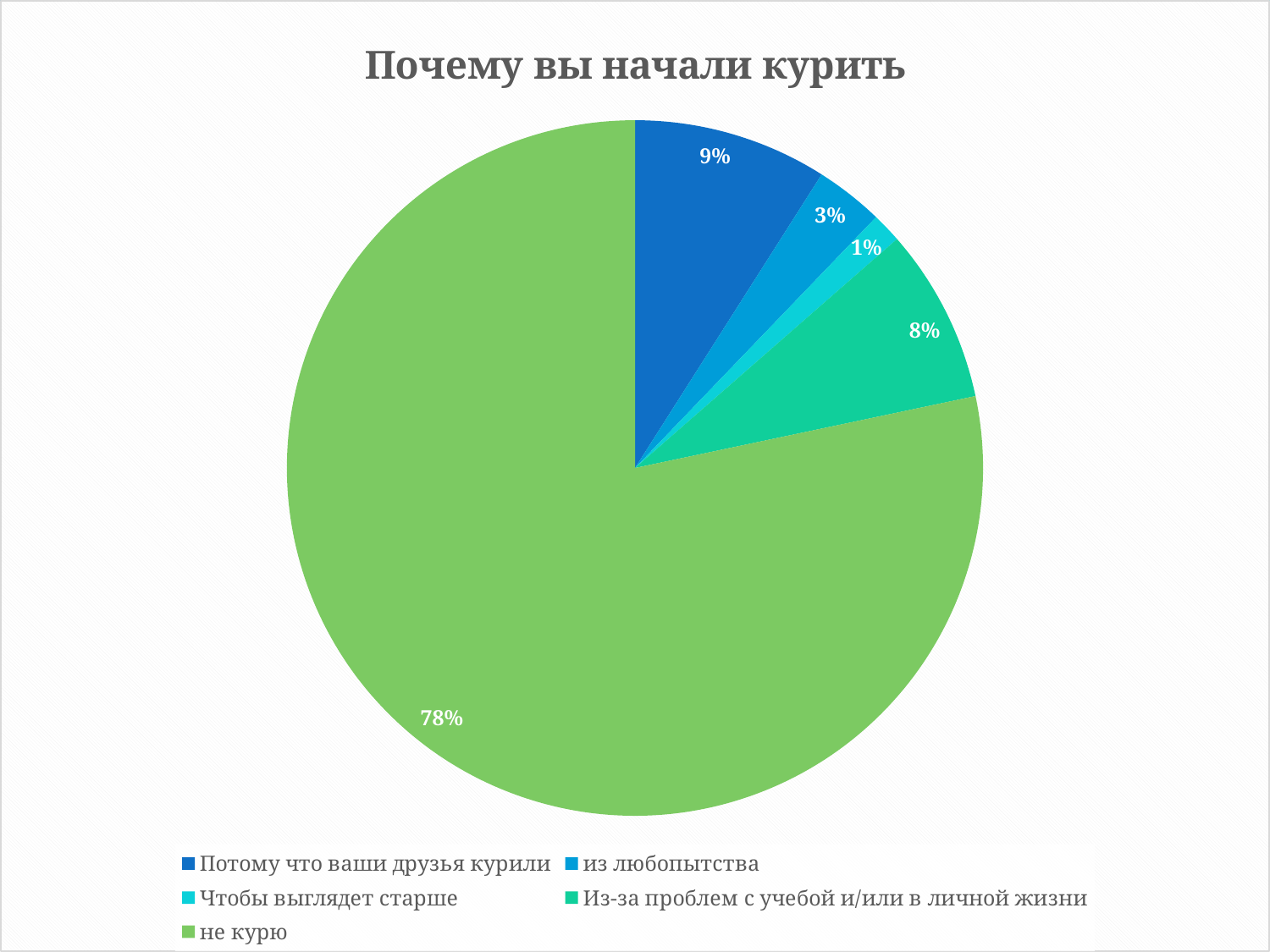
What share of the pie is labelled "не курю"? 78% Which category has the largest slice of the pie? не курю What share of the pie is labelled "из любопытства"? 3% Which is larger: the slice for "из любопытства" or the slice for "Из-за проблем с учебой и/или в личной жизни"? Из-за проблем с учебой и/или в личной жизни What share of the pie is labelled "Чтобы выглядет старше"? 1% What is the difference in percentage points between "Потому что ваши друзья курили" and "Из-за проблем с учебой и/или в личной жизни"? 1% What type of chart is shown on the slide? pie chart What share of the pie is labelled "Из-за проблем с учебой и/или в личной жизни"? 8% What is the title of the chart? Почему вы начали курить What share of the pie is labelled "Потому что ваши друзья курили"? 9% How many slices does the pie chart have? 5 Which category has the smallest slice of the pie? Чтобы выглядет старше